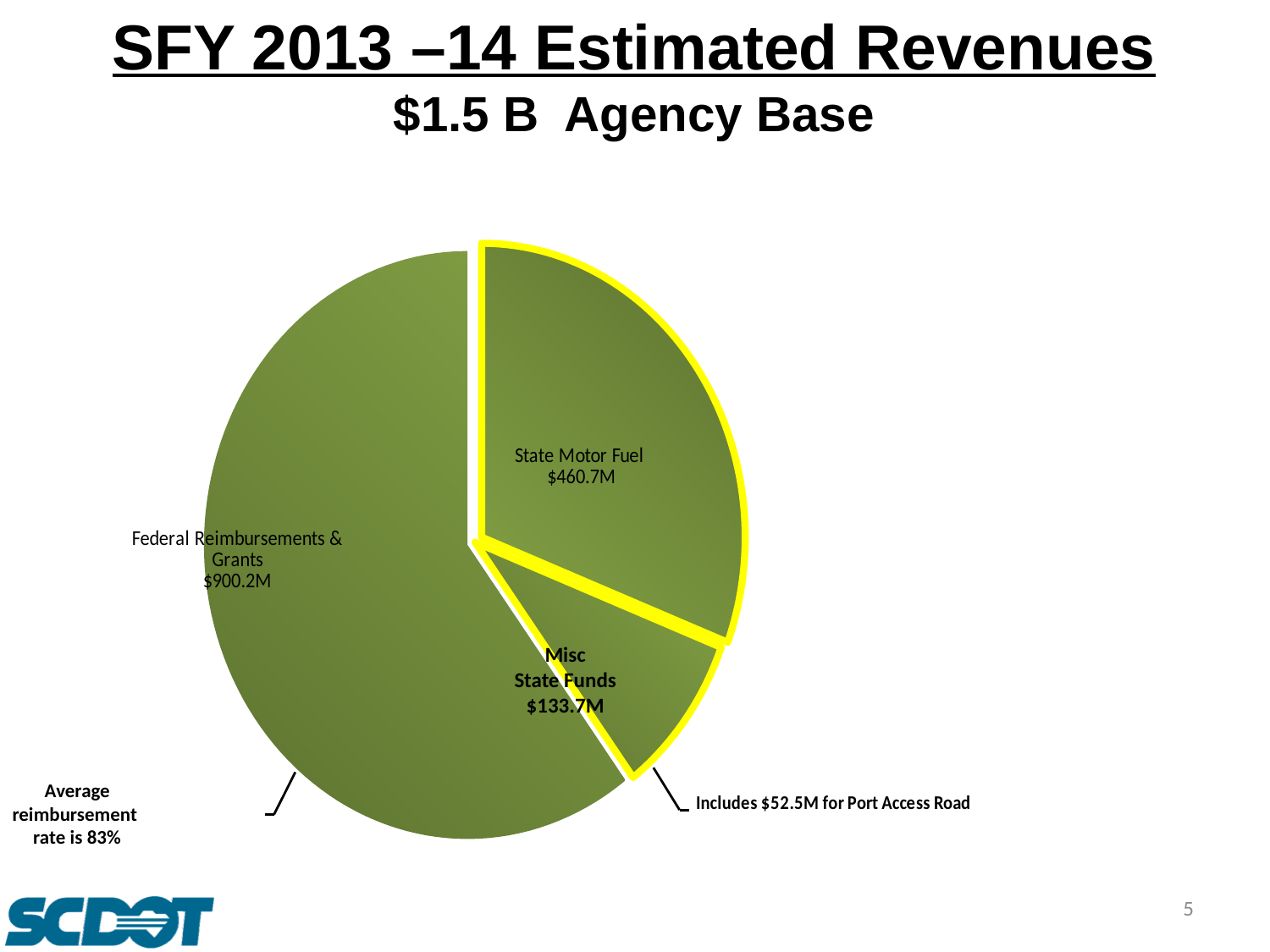
What is the value for Federal Reimbursements & Grants? $900.2M According to the annotation on the slide, what is the average reimbursement rate? 83% How many slices does the pie chart have? 3 Which revenue source is the largest slice of the pie? Federal Reimbursements & Grants What is the value for State Motor Fuel? $460.7M What is the value for Misc State Funds? $133.7M What is the difference between State Motor Fuel and Misc State Funds? $327.0M What is the title of the chart on the slide? SFY 2013 –14 Estimated Revenues What type of chart is shown on the slide? pie chart What is the difference between Federal Reimbursements & Grants and State Motor Fuel? $439.5M Which revenue source is the smallest slice of the pie? Misc State Funds Which is larger, State Motor Fuel or Misc State Funds? State Motor Fuel